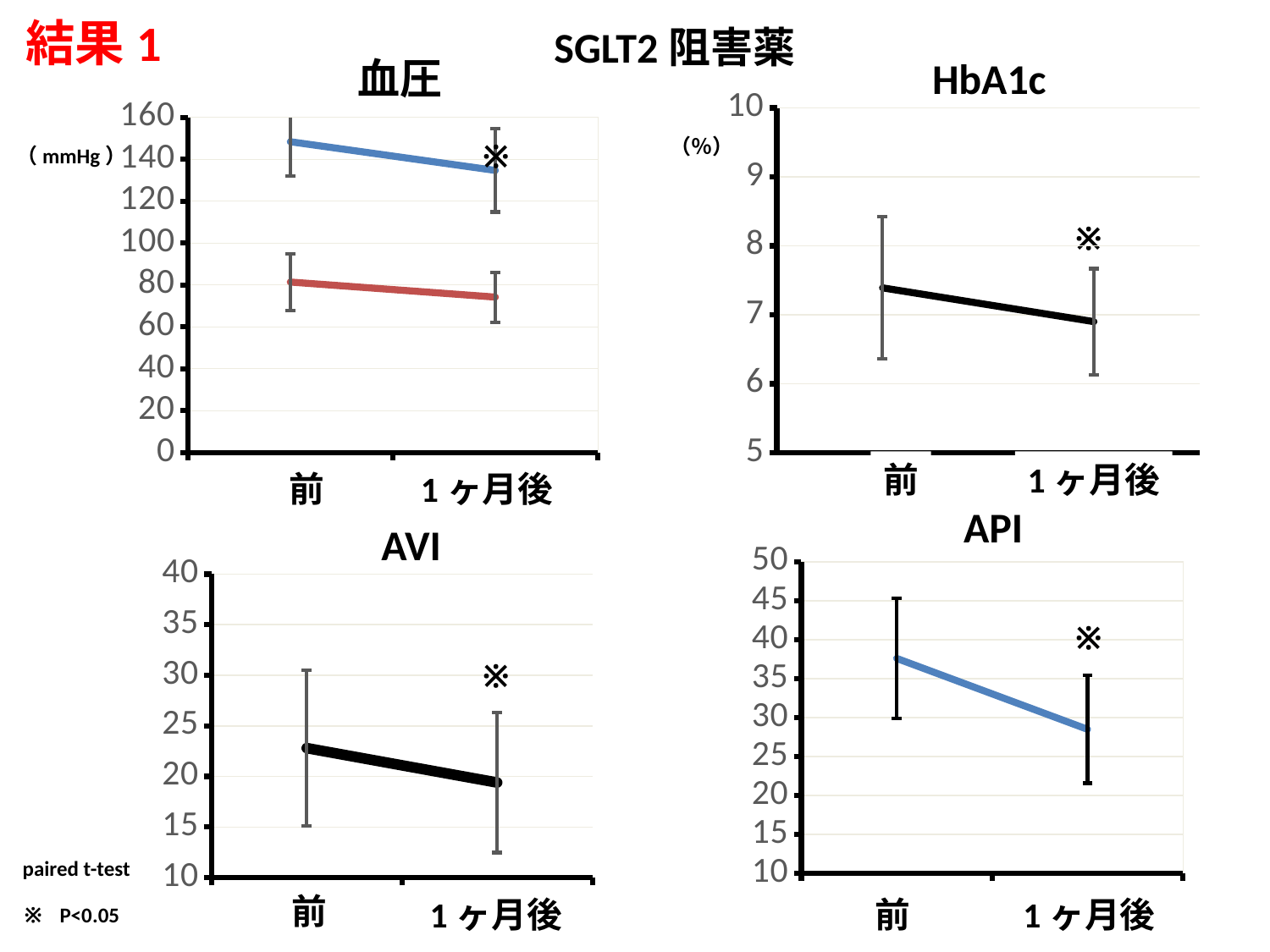
In the 血圧 chart, is the value of the blue line at 前 greater or less than 140? greater In the API chart, is the value at 前 greater or less than 35? greater In the HbA1c chart, does the value rise or fall from 前 to 1ヶ月後? fall In the 血圧 chart, is the value of the red line at 1ヶ月後 greater or less than 80? less How many x-axis categories does the API chart have? 2 What kind of chart is the 血圧 chart? line chart What unit is shown on the y axis of the 血圧 chart? mmHg How many lines are plotted in the 血圧 chart? 2 In the 血圧 chart, do the values rise or fall from 前 to 1ヶ月後? fall